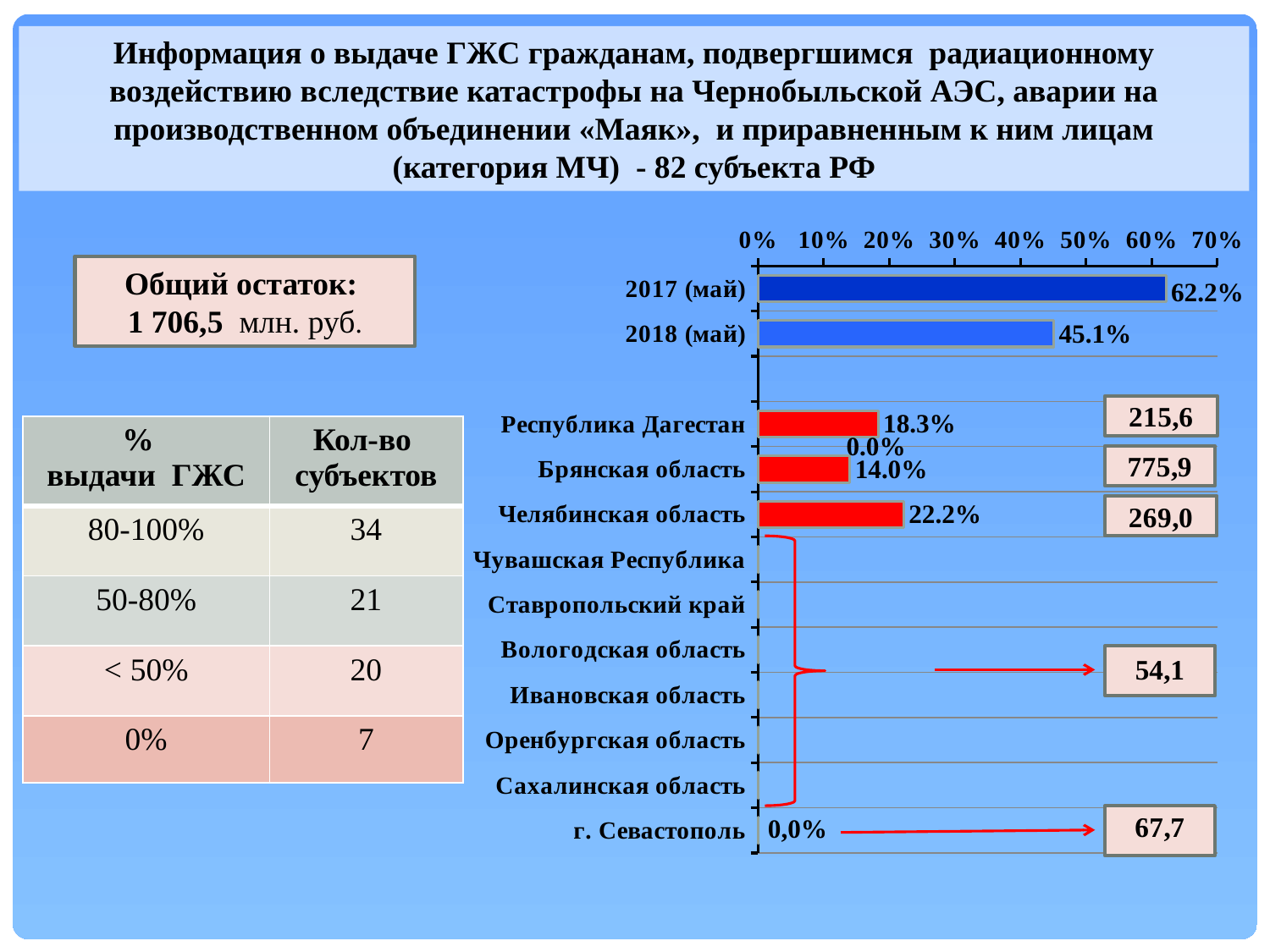
By how many percentage points does the value for 2017 (май) exceed the value for 2018 (май) in the bar chart? 17.1 Which is larger in the bar chart: the value for Республика Дагестан or the value for Челябинская область? Челябинская область What is the value shown for 2018 (май) in the bar chart? 45.1% What percentage is shown for Челябинская область in the bar chart? 22.2% What is the value shown for 2017 (май) in the bar chart? 62.2% Is the value for 2017 (май) in the bar chart greater or less than 60%? greater What kind of chart is shown on the right side of the slide? bar chart Among Республика Дагестан, Брянская область and Челябинская область, which has the lowest percentage in the bar chart? Брянская область What percentage is shown for г. Севастополь in the bar chart? 0,0% Among Республика Дагестан, Брянская область and Челябинская область, which has the highest percentage in the bar chart? Челябинская область What percentage is shown for Республика Дагестан in the bar chart? 18.3% What percentage is shown for Брянская область in the bar chart? 14.0%